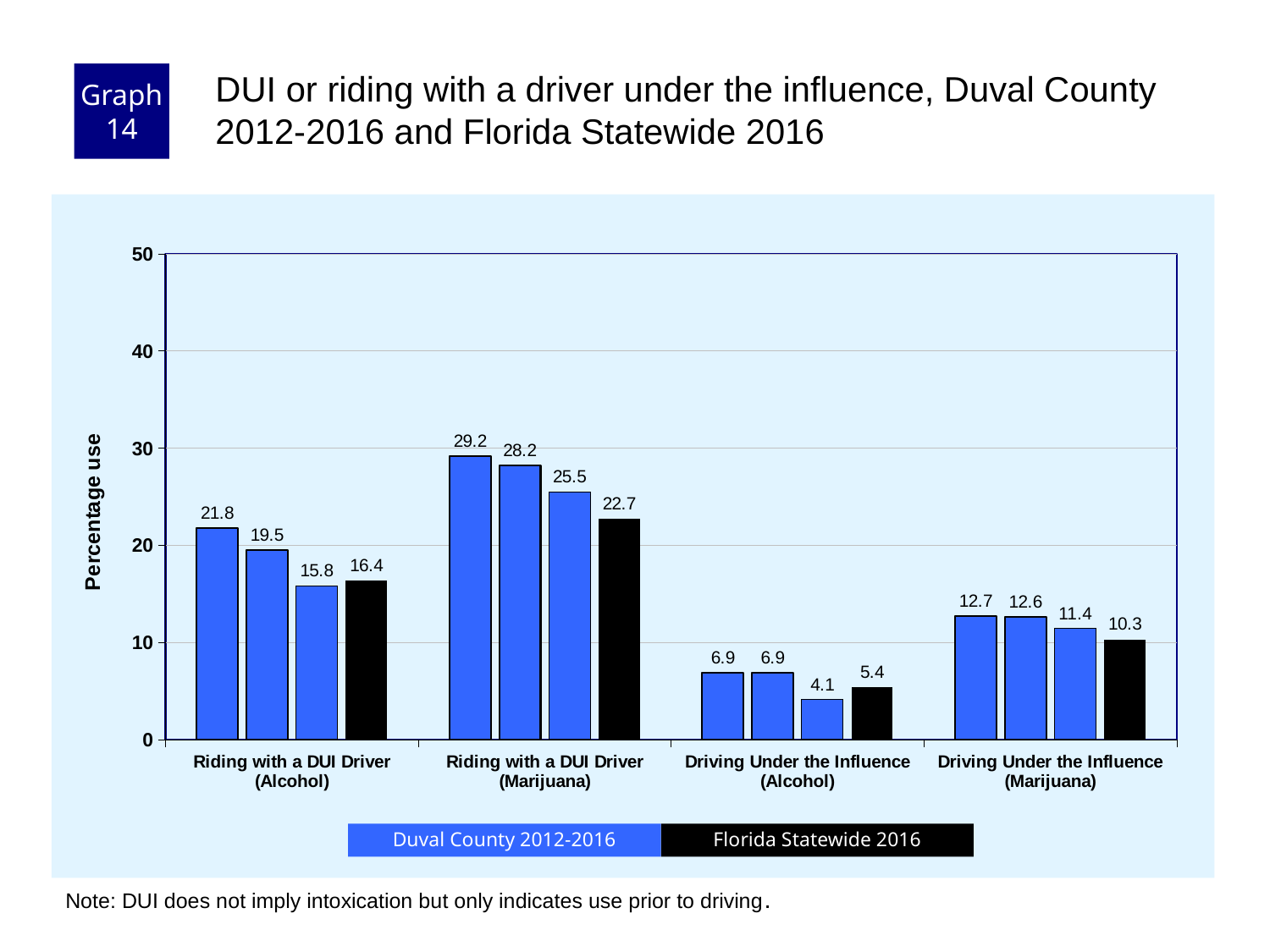
What is the Florida Statewide 2016 value for Driving Under the Influence (Alcohol)? 5.4 What is the Florida Statewide 2016 value for Driving Under the Influence (Marijuana)? 10.3 Which category has the highest bar on the chart? Riding with a DUI Driver (Marijuana) What is the label of the y axis? Percentage use What is the Florida Statewide 2016 value for Riding with a DUI Driver (Alcohol)? 16.4 What kind of chart is shown on the slide? bar chart What is the difference between the Florida Statewide 2016 values for Riding with a DUI Driver (Marijuana) and Riding with a DUI Driver (Alcohol)? 6.3 What is the Florida Statewide 2016 value for Riding with a DUI Driver (Marijuana)? 22.7 How many categories are shown on the x axis? 4 How many series does the legend list? 2 Which category has the lowest bar on the chart? Driving Under the Influence (Alcohol) Is the Florida Statewide 2016 value for Riding with a DUI Driver (Marijuana) larger or smaller than the Florida Statewide 2016 value for Driving Under the Influence (Marijuana)? larger